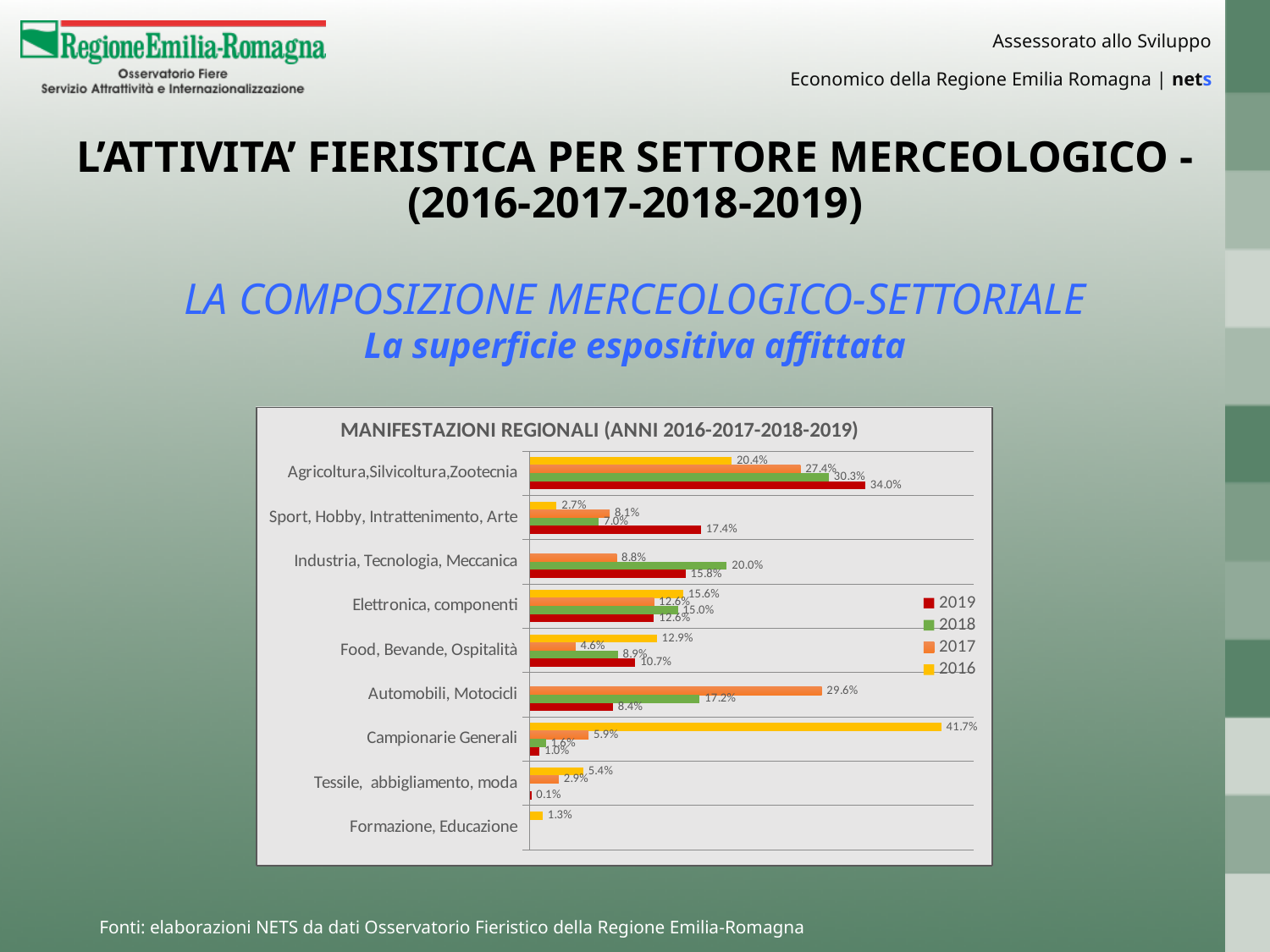
Which category has the highest 2019 value? Agricoltura,Silvicoltura,Zootecnia What is the 2018 value for Industria, Tecnologia, Meccanica? 20.0% What is the 2019 value for Agricoltura,Silvicoltura,Zootecnia? 34.0% What is the 2016 value for Campionarie Generali? 41.7% What is the 2017 value for Automobili, Motocicli? 29.6% How many categories are shown on the chart? 9 What is the title of the chart? MANIFESTAZIONI REGIONALI (ANNI 2016-2017-2018-2019) For Automobili, Motocicli, which is larger: the 2017 value or the 2018 value? 2017 What type of chart is shown on the slide? Bar chart What is the difference between the 2019 and 2016 values for Agricoltura,Silvicoltura,Zootecnia? 13.6 percentage points Which category has the lowest 2019 value? Tessile, abbigliamento, moda How many series does the legend list? 4